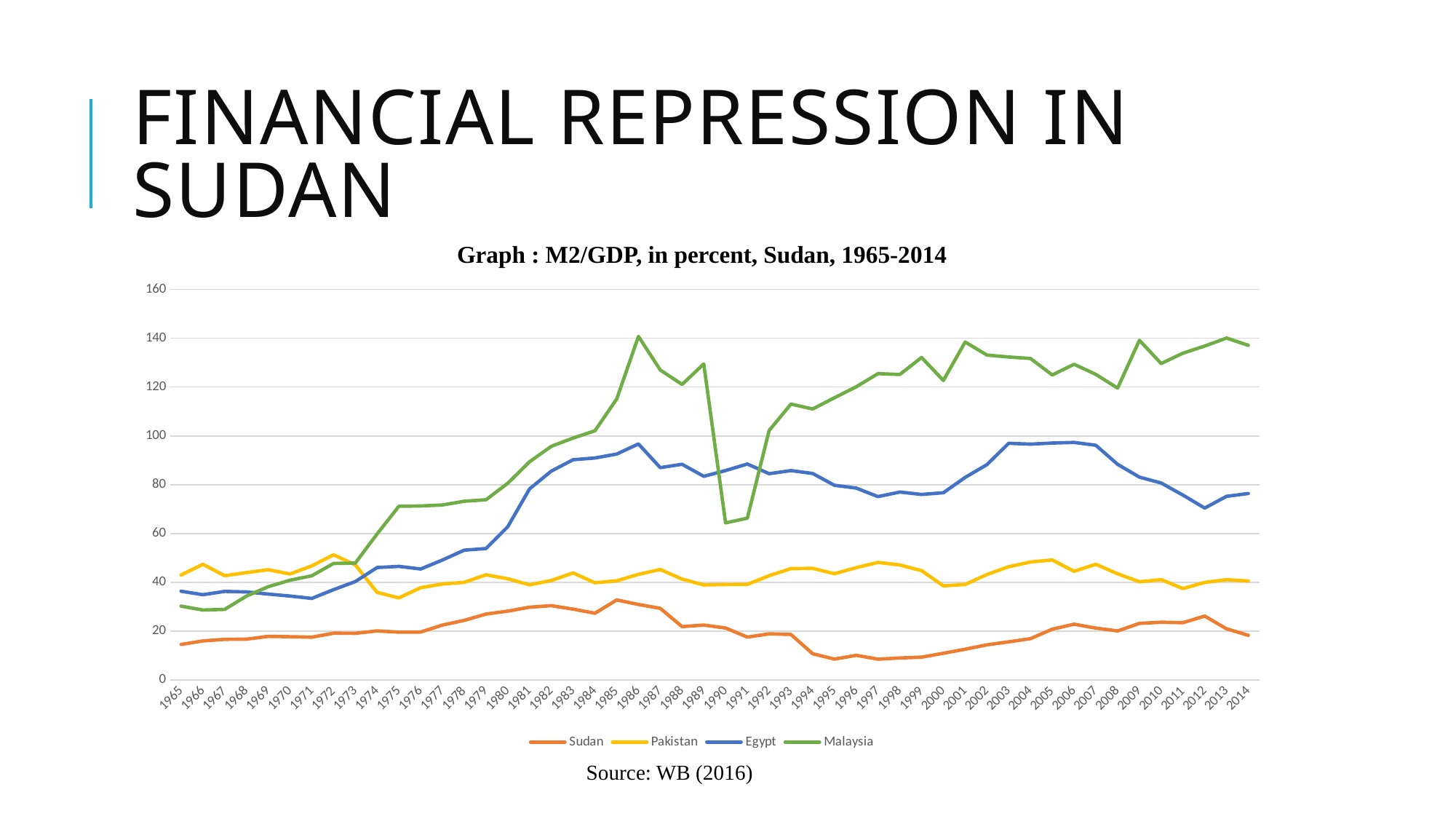
How many series does the legend list? 4 In 2014, which is larger, the value for Malaysia or the value for Egypt? Malaysia In 1965, which is larger, the value for Pakistan or the value for Sudan? Pakistan Is the value for Sudan in 1995 greater or less than 20? less How many years are plotted along the x axis? 50 Is the value for Egypt in 2003 greater or less than 80? greater Is the value for Malaysia in 1990 greater or less than 80? less What kind of chart is shown on the slide? line chart Which series has the highest value in 2005? Malaysia Which series has the lowest value in 2000? Sudan What is the title of the chart? Graph : M2/GDP, in percent, Sudan, 1965-2014